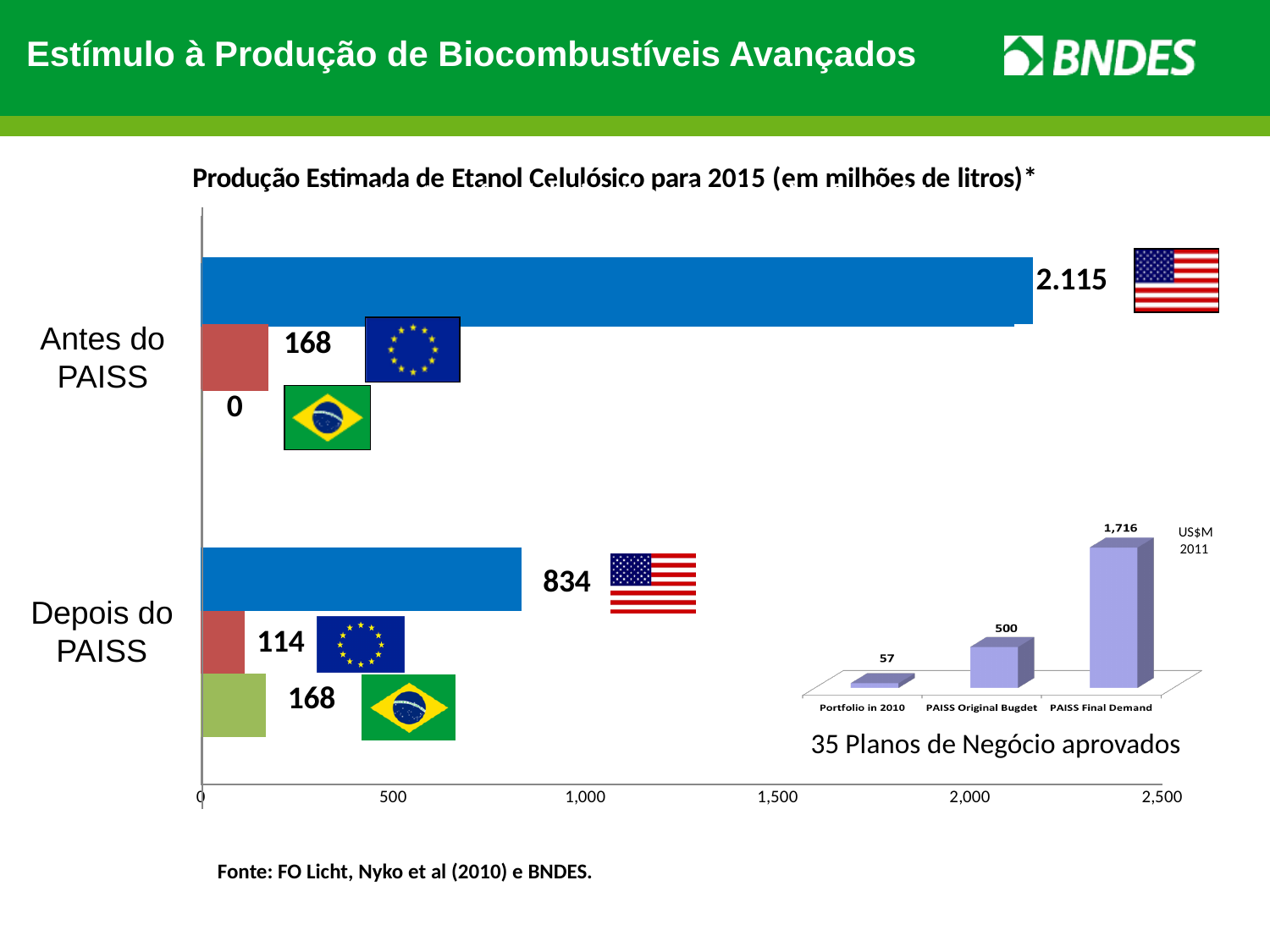
In the small inset chart at the lower right, which category has the lowest value? Portfolio in 2010 In the main chart 'Produção Estimada de Etanol Celulósico para 2015', what is the value of the bar with the EU flag for 'Depois do PAISS'? 114 In the small inset chart at the lower right, how many categories are shown? 3 In the main chart 'Produção Estimada de Etanol Celulósico para 2015', is the US-flag value for 'Depois do PAISS' greater or less than 1,000? less In the main chart 'Produção Estimada de Etanol Celulósico para 2015', which of the two US-flag bars is larger, 'Antes do PAISS' or 'Depois do PAISS'? Antes do PAISS What kind of chart is the main chart 'Produção Estimada de Etanol Celulósico para 2015'? bar chart In the main chart 'Produção Estimada de Etanol Celulósico para 2015', what is the value of the bar with the US flag for 'Antes do PAISS'? 2.115 In the main chart 'Produção Estimada de Etanol Celulósico para 2015', what is the value of the bar with the Brazilian flag for 'Depois do PAISS'? 168 In the main chart 'Produção Estimada de Etanol Celulósico para 2015', what is the value of the bar with the Brazilian flag for 'Antes do PAISS'? 0 In the small inset chart at the lower right, what is the value for 'Portfolio in 2010'? 57 In the small inset chart at the lower right, what is the value for 'PAISS Final Demand'? 1,716 In the main chart 'Produção Estimada de Etanol Celulósico para 2015', what is the difference between the EU-flag values for 'Antes do PAISS' (168) and 'Depois do PAISS' (114)? 54